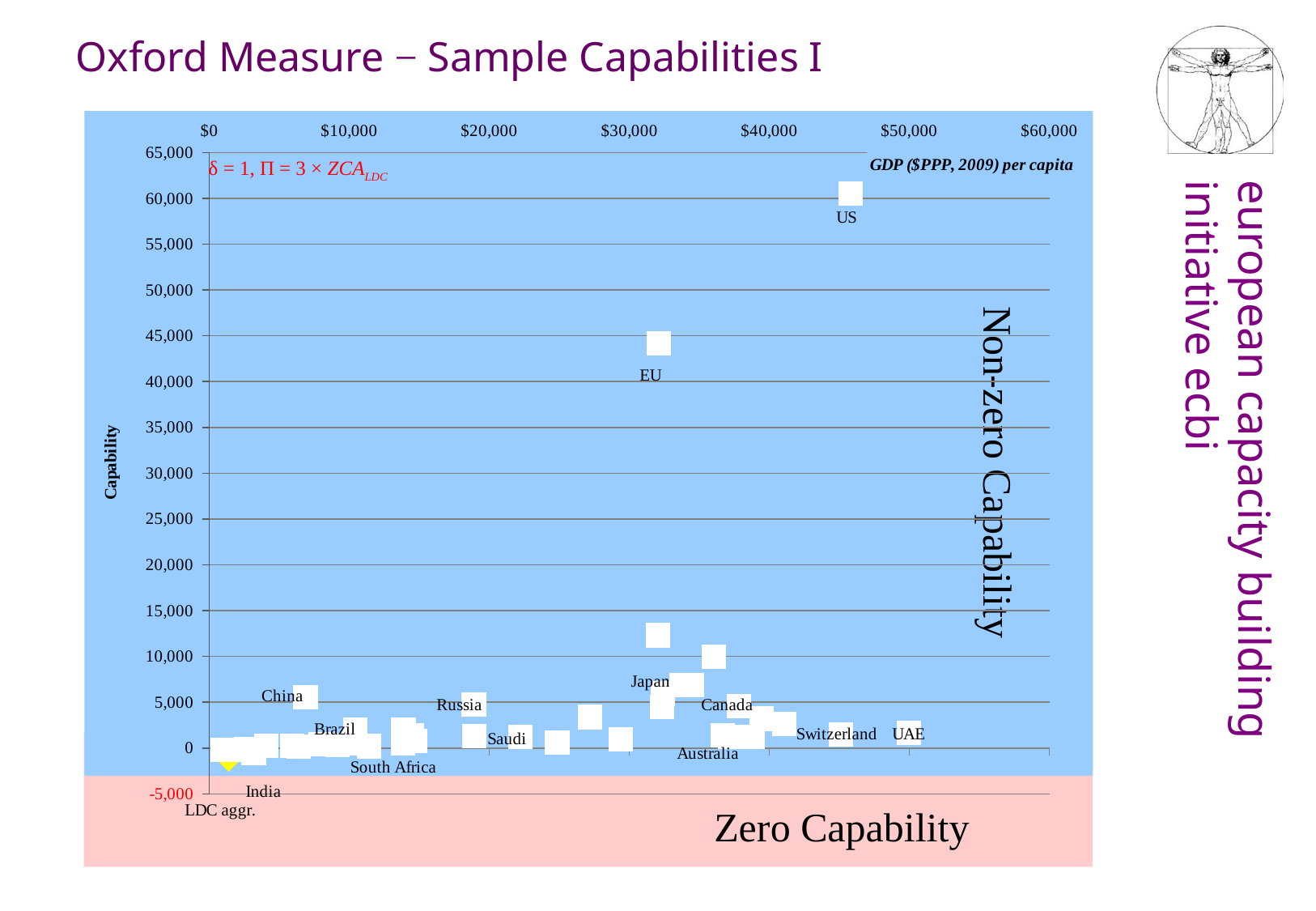
Which labelled country or region has the highest Capability value? US Is the Capability value for China greater or less than 10,000? less Is the Capability value for the US greater or less than 55,000? greater Is the Capability value for the EU greater or less than 40,000? greater Which has the higher Capability value, the EU or Japan? EU What is the title of the vertical axis? Capability Which has the higher Capability value, the US or the EU? US What kind of chart is shown on the slide? scatter chart What is the label of the horizontal axis? GDP ($PPP, 2009) per capita